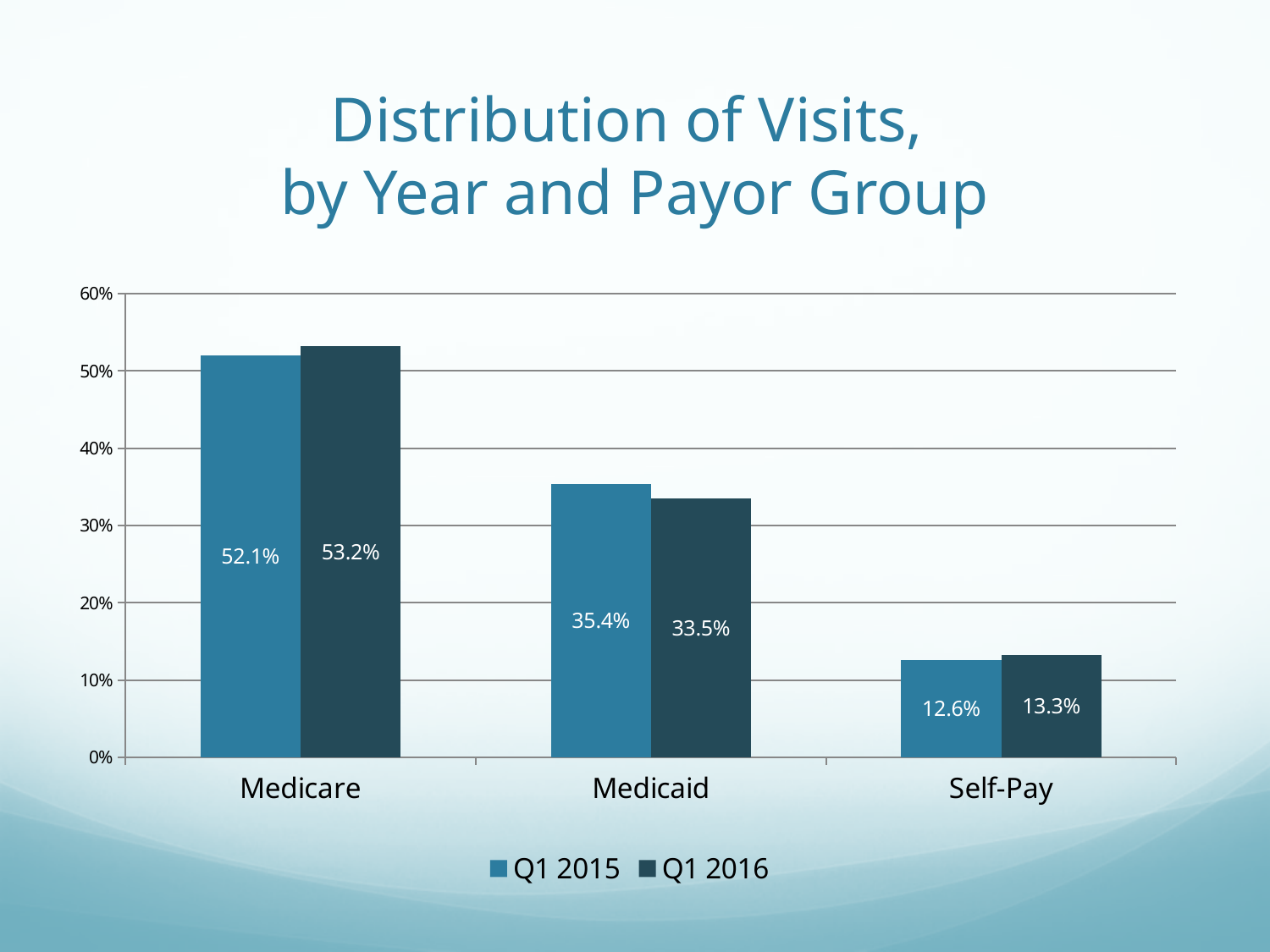
What kind of chart is shown on the slide? Bar chart Which is larger for Medicaid, the Q1 2015 value or the Q1 2016 value? Q1 2015 How many series does the legend list? 2 Which payor group has the lowest Q1 2015 value? Self-Pay What is the Q1 2016 value for Medicaid? 33.5% Which payor group has the highest Q1 2016 value? Medicare What is the difference between the Q1 2015 and Q1 2016 values for Medicaid? 1.9% What is the title of the chart? Distribution of Visits, by Year and Payor Group What is the difference between the Q1 2016 values for Medicare and Self-Pay? 39.9% How many payor groups are shown on the x axis? 3 What is the Q1 2015 value for Medicare? 52.1% What is the Q1 2016 value for Self-Pay? 13.3%